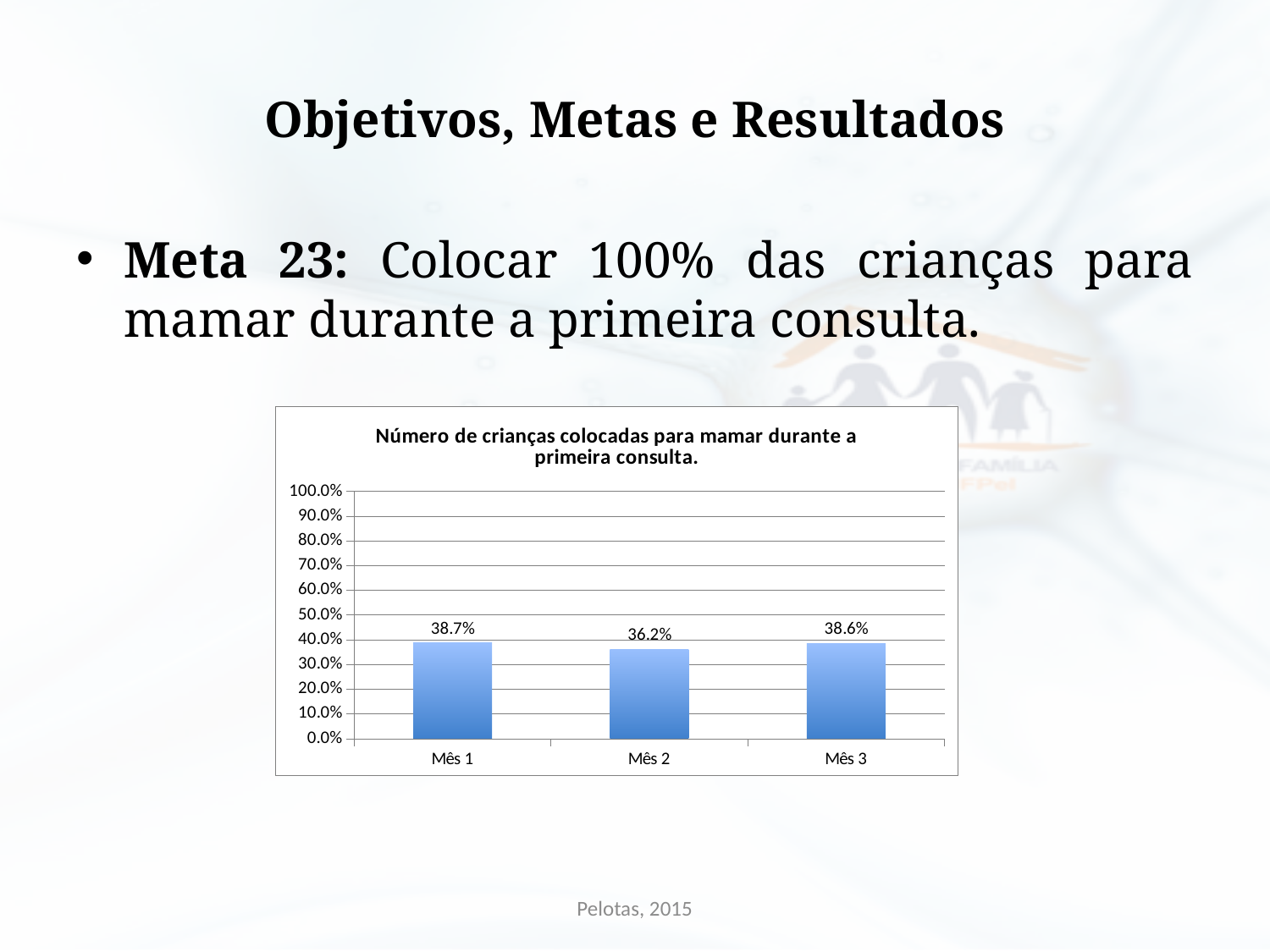
What is the title of the chart? Número de crianças colocadas para mamar durante a primeira consulta. What is the difference between the values for Mês 1 and Mês 2? 2.5% What is the value for Mês 1? 38.7% Which month has the highest value? Mês 1 What is the value for Mês 2? 36.2% How many months are shown on the x axis? 3 Which is larger, the value for Mês 1 or the value for Mês 2? Mês 1 What is the value for Mês 3? 38.6% Which month has the lowest value? Mês 2 What kind of chart is shown on the slide? bar chart Is the value for Mês 2 greater or less than 50.0%? less What is the difference between the values for Mês 3 and Mês 2? 2.4%